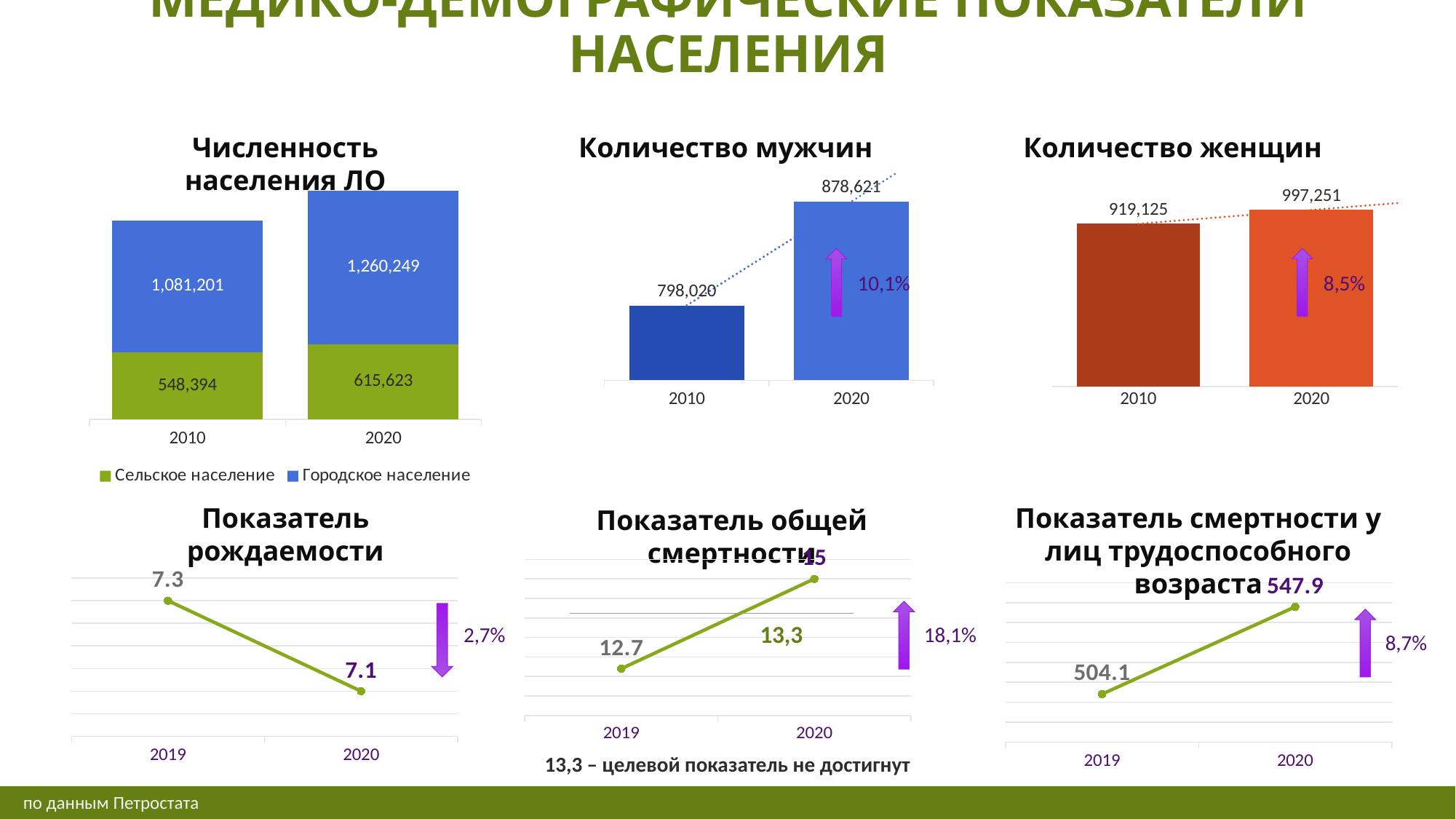
In the 'Показатель смертности у лиц трудоспособного возраста' chart, what is the difference between the 2020 and 2019 values? 43.8 In the 'Количество женщин' chart, what is the value for 2010? 919,125 In the 'Численность населения ЛО' chart, what is the value for Сельское население in 2010? 548,394 What kind of chart is the 'Показатель рождаемости' chart? line chart In the 'Количество мужчин' chart, what is the value for 2020? 878,621 In the 'Показатель общей смертности' chart, what is the value for 2019? 12.7 How many series does the legend of the 'Численность населения ЛО' chart list? 2 In the 'Численность населения ЛО' chart, what is the value for Городское население in 2020? 1,260,249 In the 'Количество мужчин' chart, what is the difference between the 2020 and 2010 values? 80,601 In the 'Показатель рождаемости' chart, do the values rise or fall from 2019 to 2020? fall In the 'Численность населения ЛО' chart, what is the total of the stacked bar for 2010? 1,629,595 In the 'Количество женщин' chart, which year has the higher value? 2020